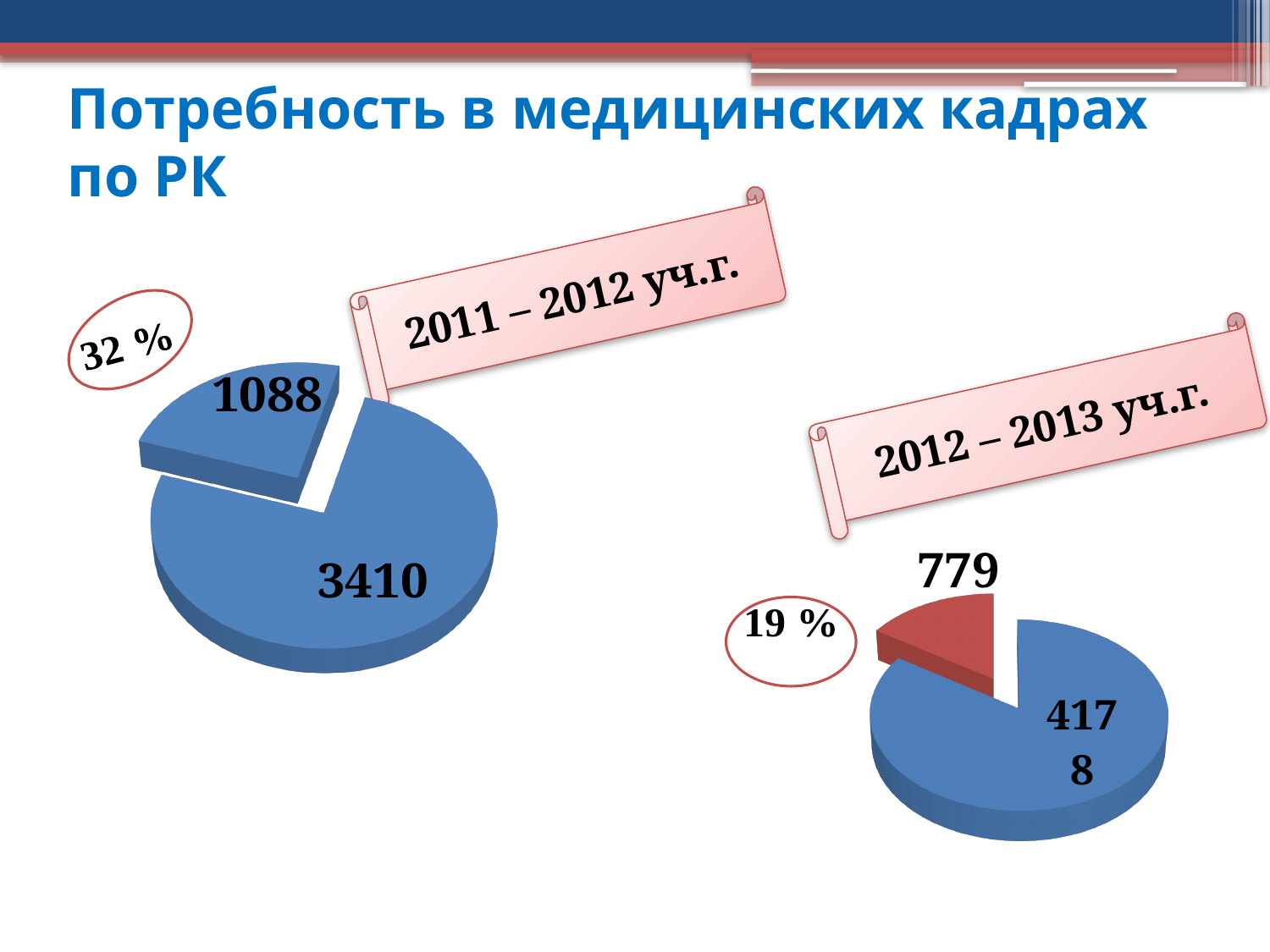
How many slices does the pie chart labelled 2011 – 2012 уч.г. have? 2 In the pie chart labelled 2012 – 2013 уч.г., what value is printed on the red slice? 779 Which is larger: the pulled-out slice of the 2011 – 2012 уч.г. pie chart or the red slice of the 2012 – 2013 уч.г. pie chart? the pulled-out slice of the 2011 – 2012 уч.г. chart (1088) In the pie chart labelled 2012 – 2013 уч.г., what is the total of the two slice values? 4957 In the pie chart labelled 2011 – 2012 уч.г., what value is printed on the smaller, pulled-out slice? 1088 What kind of chart is the chart labelled 2011 – 2012 уч.г. on the left of the slide? pie chart In the pie chart labelled 2012 – 2013 уч.г., what is the difference between the blue slice value and the red slice value? 3399 In the pie chart labelled 2011 – 2012 уч.г., what is the total of the two slice values? 4498 In the pie chart labelled 2012 – 2013 уч.г., what value is printed on the blue slice? 4178 In the pie chart labelled 2011 – 2012 уч.г., what value is printed on the larger slice? 3410 In the pie chart labelled 2011 – 2012 уч.г., what is the difference between the two slice values? 2322 What percentage is written in the circle next to the pie chart labelled 2012 – 2013 уч.г.? 19 %